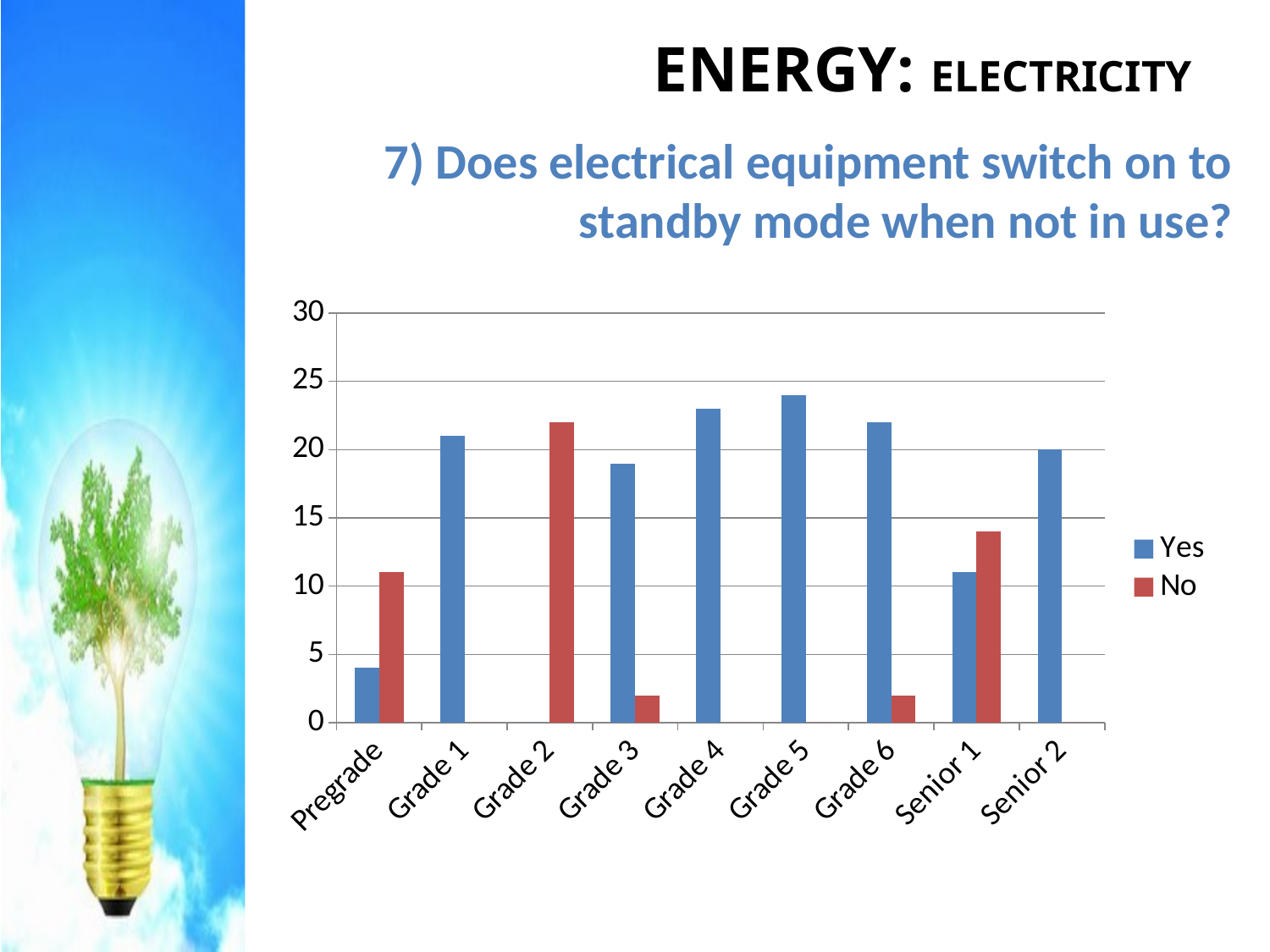
For Senior 1, which is larger, the 'Yes' value or the 'No' value? No For Pregrade, which is larger, the 'Yes' value or the 'No' value? No Is the 'Yes' value for Grade 1 greater or less than 20? greater Is the 'No' value for Senior 1 greater or less than 15? less Which category has the highest 'No' value? Grade 2 What kind of chart is shown on the slide? bar chart What colour are the 'No' bars in the chart? red Which category has the lowest 'Yes' value? Grade 2 How many grade categories are shown on the x axis? 9 How many series does the legend list? 2 Is the 'Yes' value for Pregrade greater or less than 5? less